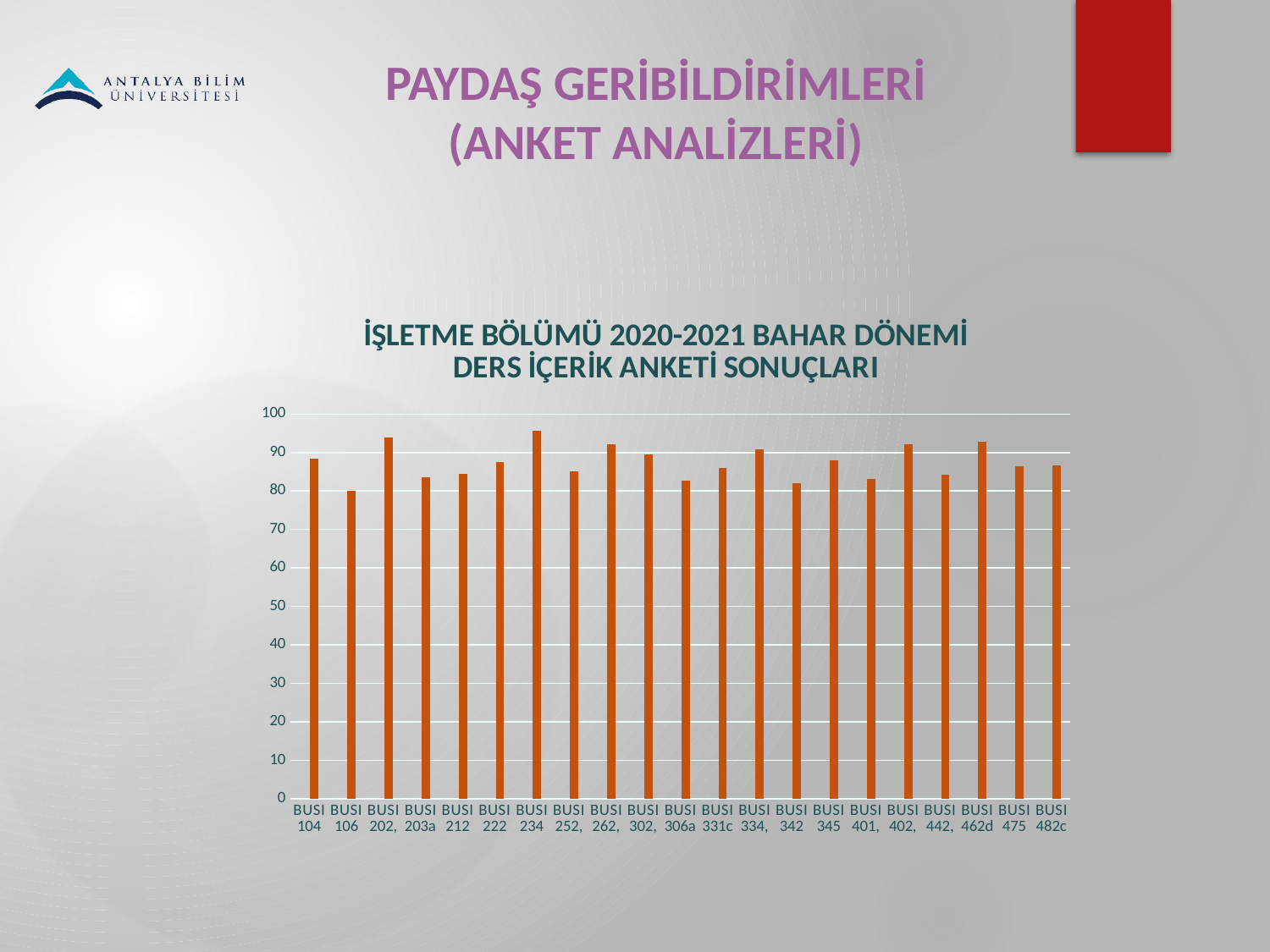
What kind of chart is shown on the slide? bar chart Which is larger, the value for BUSI 202 or the value for BUSI 203a? BUSI 202 Is the value for BUSI 203a greater or less than 90? less Which course has the highest bar in the chart? BUSI 234 Which is larger, the value for BUSI 234 or the value for BUSI 106? BUSI 234 How many courses (categories) are plotted on the x axis of the chart? 21 Is the value for BUSI 234 greater or less than 90? greater Is the value for BUSI 342 greater or less than 90? less What is the maximum value shown on the chart's vertical axis? 100 What is the title of the chart? İŞLETME BÖLÜMÜ 2020-2021 BAHAR DÖNEMİ DERS İÇERİK ANKETİ SONUÇLARI Which course has the lowest bar in the chart? BUSI 106